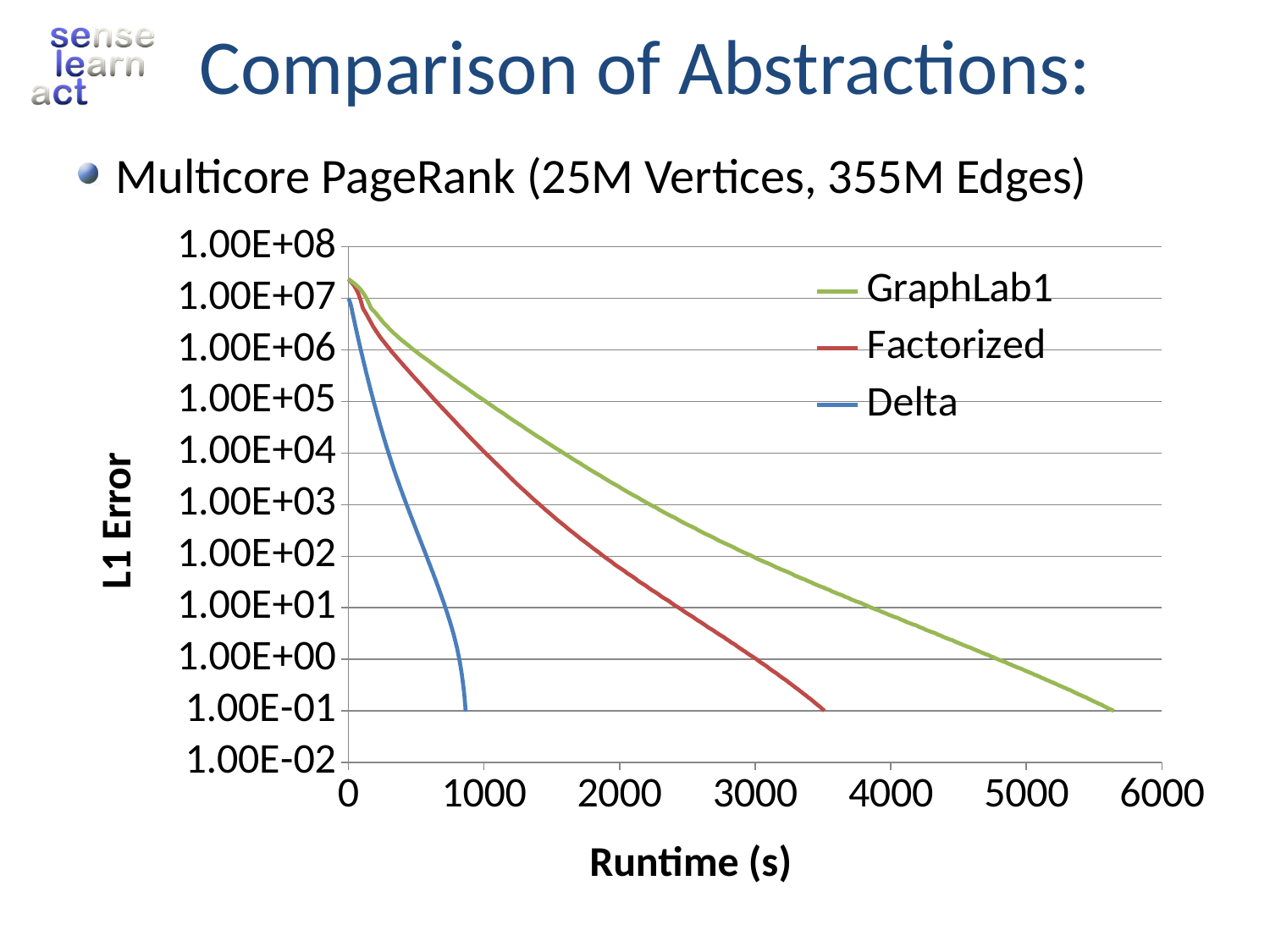
How many series does the chart legend list? 3 Which series reaches an L1 Error of 1.00E-01 in the shortest runtime? Delta At a runtime of 3000 s, is the L1 Error of the GraphLab1 series greater or less than 1.00E+01? greater Does the L1 Error for each series rise or fall as runtime increases? fall Is the runtime at which the Delta series reaches 1.00E-01 L1 Error greater or less than 1000? less Is the runtime at which the Factorized series reaches 1.00E-01 L1 Error greater or less than 3000? greater Which series are listed in the chart legend? GraphLab1, Factorized, Delta At a runtime of 2000 s, which series has the lower L1 Error, GraphLab1 or Factorized? Factorized What kind of chart is shown on the slide? line chart Which series takes the longest runtime to reach an L1 Error of 1.00E-01? GraphLab1 What is the title of the chart's vertical axis? L1 Error